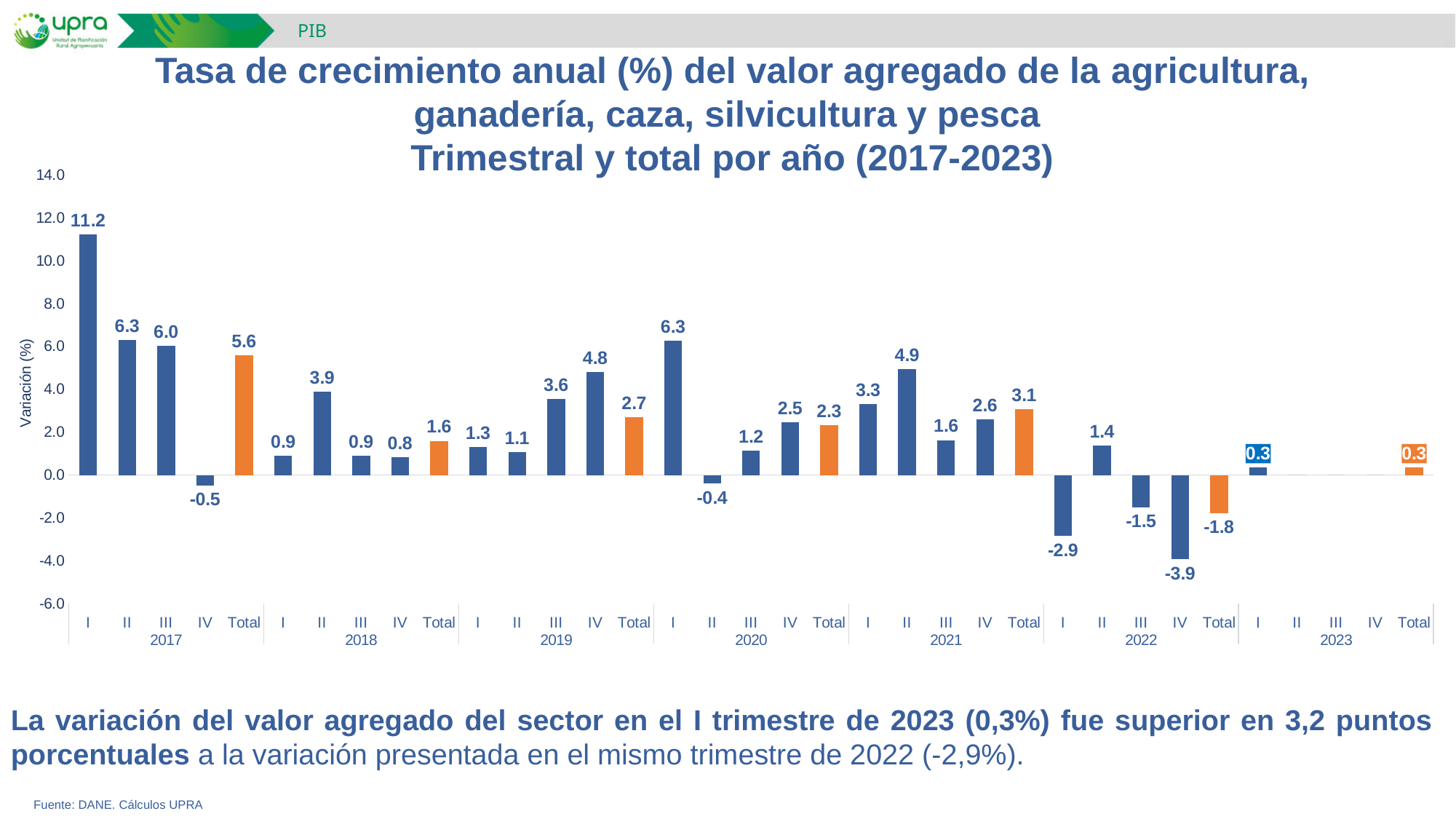
What is the annual total growth rate shown for 2022? -1.8 What is the difference between the annual total for 2017 and the annual total for 2021? 2.5 What is the difference between the value for quarter I of 2023 and quarter I of 2022? 3.2 Which bar has the lowest value on the chart? IV 2022 (-3.9) What is the annual growth rate for the first quarter (I) of 2017? 11.2 What kind of chart is shown on the slide? Bar chart What colour are the annual 'Total' bars on the chart? Orange What is the value for the fourth quarter (IV) of 2019? 4.8 How many annual 'Total' bars are shown on the chart? 7 Which is larger, the value for quarter II of 2018 or the value for quarter III of 2019? II 2018 (3.9) Which bar has the highest value on the chart? I 2017 (11.2) Do the quarterly values rise or fall from quarter I to quarter IV of 2017? Fall